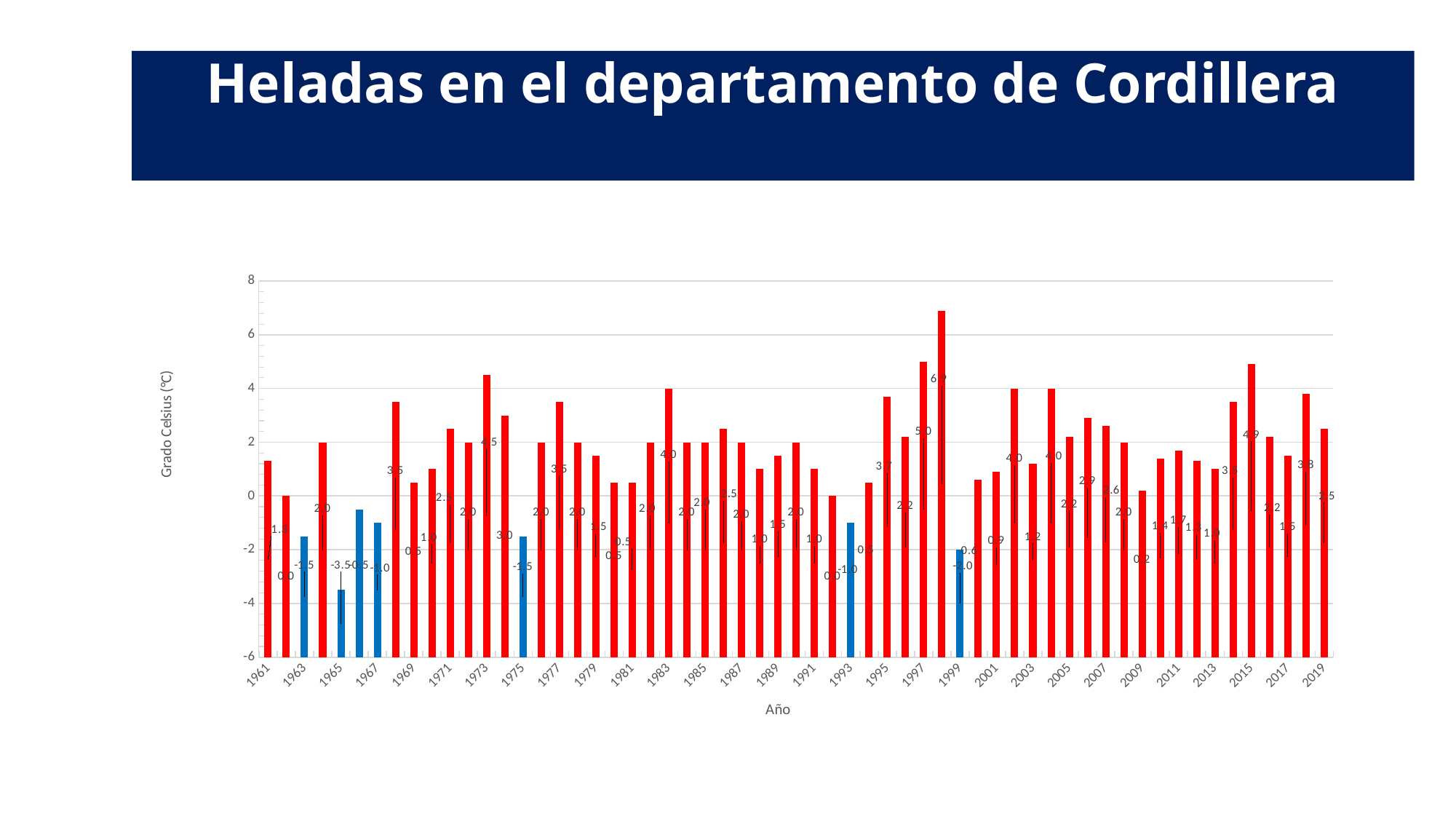
What is the value for 1998? 6.9 Which year has the lowest value in the chart? 1965 How many years are shown with blue (negative) bars? 7 What is the label of the vertical axis? Grado Celsius (°C) Which year has the highest value in the chart? 1998 What kind of chart is shown on the slide? bar chart What is the value for 1965? -3.5 What is the value for 1997? 5.0 Is the value for 1965 greater or less than -2? less Is the value for 1968 greater or less than 2? greater What is the difference between the values for 1998 and 1997? 1.9 Which is larger, the value for 1973 or the value for 1974? 1973